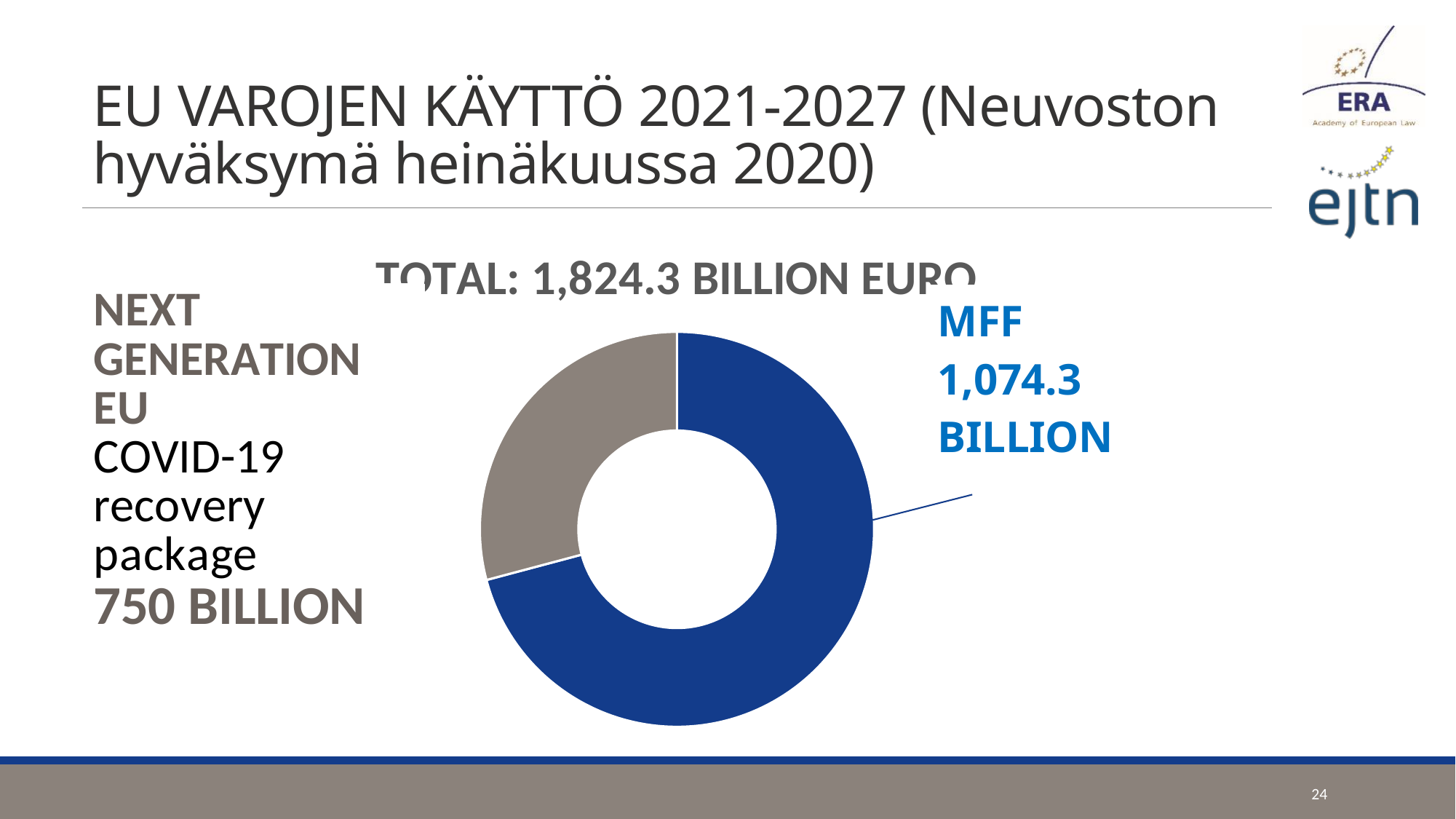
Which slice is the smallest? Next Generation EU COVID-19 recovery package What is the value of the Next Generation EU COVID-19 recovery package slice? 750 billion What is the total shown for the chart? 1,824.3 billion euro What colour is the MFF slice? Blue What colour is the Next Generation EU slice? Grey What is the difference between the MFF value and the Next Generation EU value? 324.3 billion What kind of chart is shown on the slide? Doughnut (pie) chart Which slice is the largest? MFF How many slices does the doughnut chart have? 2 Which is larger, the MFF slice or the Next Generation EU slice? MFF What is the value of the MFF slice? 1,074.3 billion